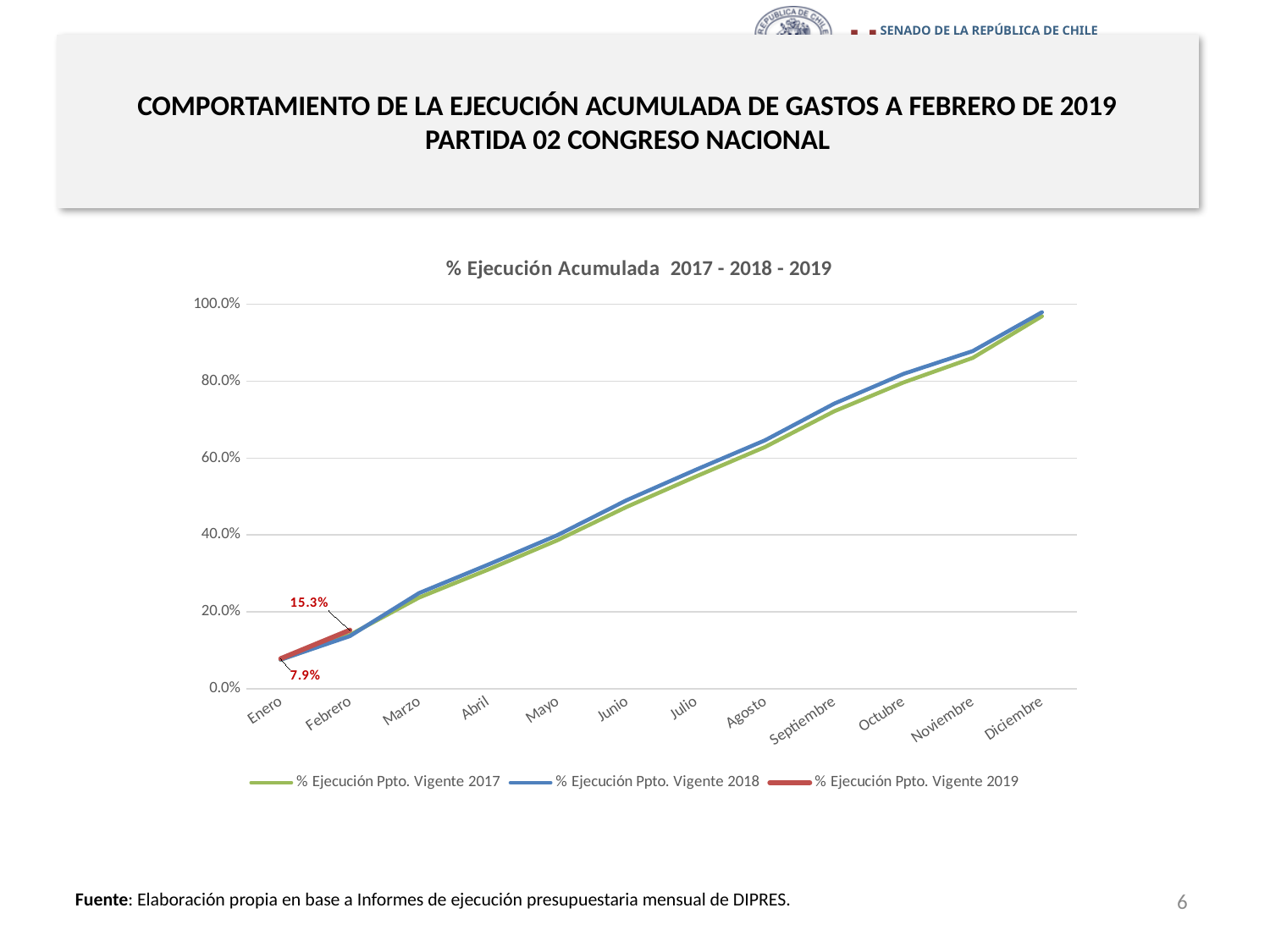
Is the value for % Ejecución Ppto. Vigente 2018 in Diciembre greater or less than 80.0%? greater Which month has the lowest value for % Ejecución Ppto. Vigente 2017? Enero What is the difference between the 2019 values for Febrero and Enero? 7.4 percentage points What is the value of % Ejecución Ppto. Vigente 2019 for Enero? 7.9% Do the values for % Ejecución Ppto. Vigente 2018 rise or fall from Enero to Diciembre? rise How many series does the legend list? 3 How many months are shown on the x axis? 12 What kind of chart is shown on the slide? line chart Which month has the highest value for % Ejecución Ppto. Vigente 2018? Diciembre Is the value for % Ejecución Ppto. Vigente 2017 in Marzo greater or less than 40.0%? less What is the value of % Ejecución Ppto. Vigente 2019 for Febrero? 15.3% What is the title of the chart? % Ejecución Acumulada 2017 - 2018 - 2019